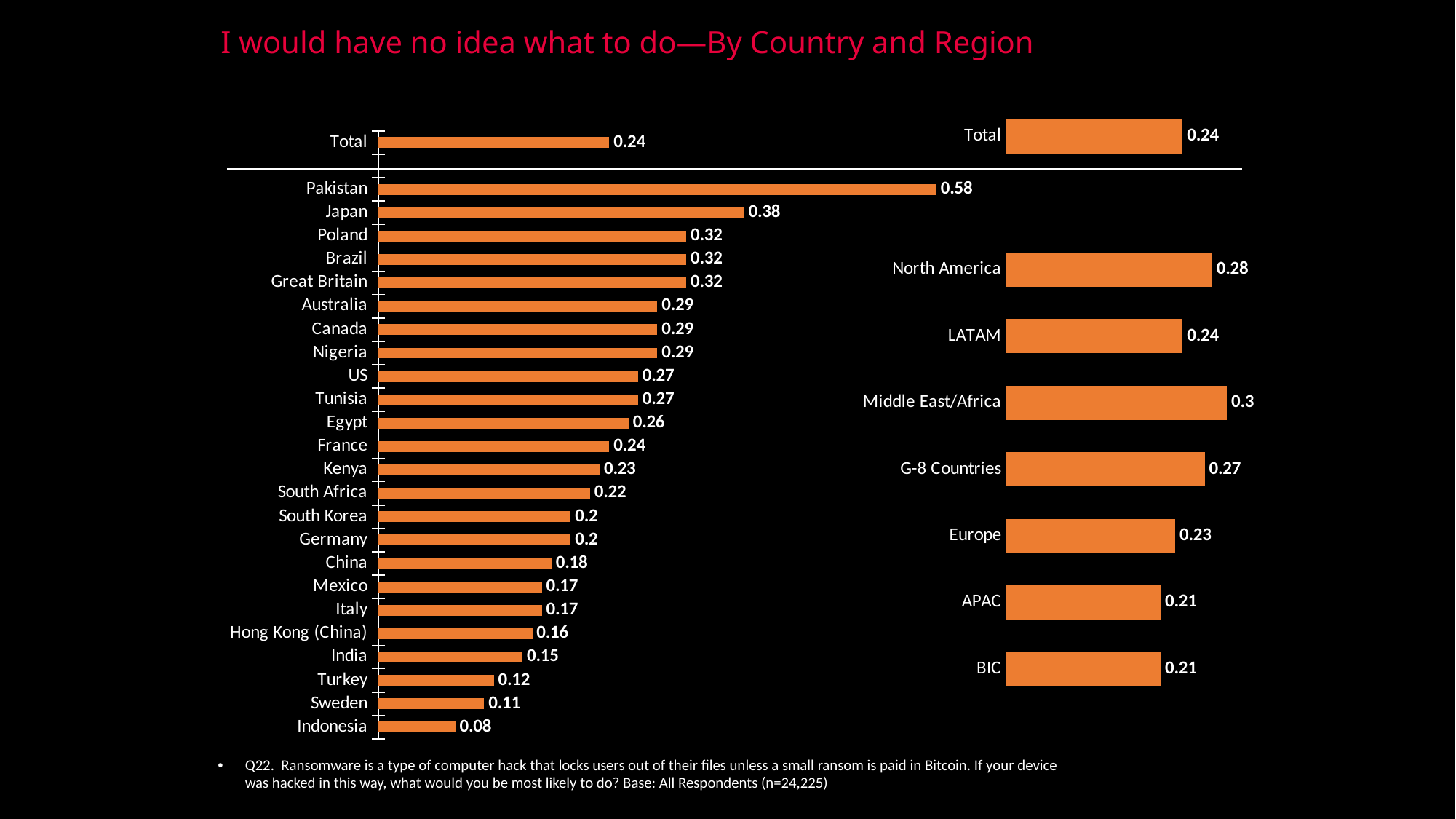
In the left chart (by country), which country has the lowest value? Indonesia In the right chart (by region), what is the value for Middle East/Africa? 0.3 In the left chart (by country), what is the value for Pakistan? 0.58 What kind of chart is used on the left side of the slide? Bar chart In the left chart (by country), which has the larger value, Egypt or Kenya? Egypt In the left chart (by country), how many countries are listed below the Total bar? 24 In the right chart (by region), which region has the highest value? Middle East/Africa In the left chart (by country), which country has the highest value? Pakistan In the left chart (by country), what is the value for Indonesia? 0.08 In the left chart (by country), what is the difference between the values for Pakistan and Japan? 0.2 In the right chart (by region), what is the difference between the values for North America and Europe? 0.05 In the right chart (by region), how many regions are listed below the Total bar? 7